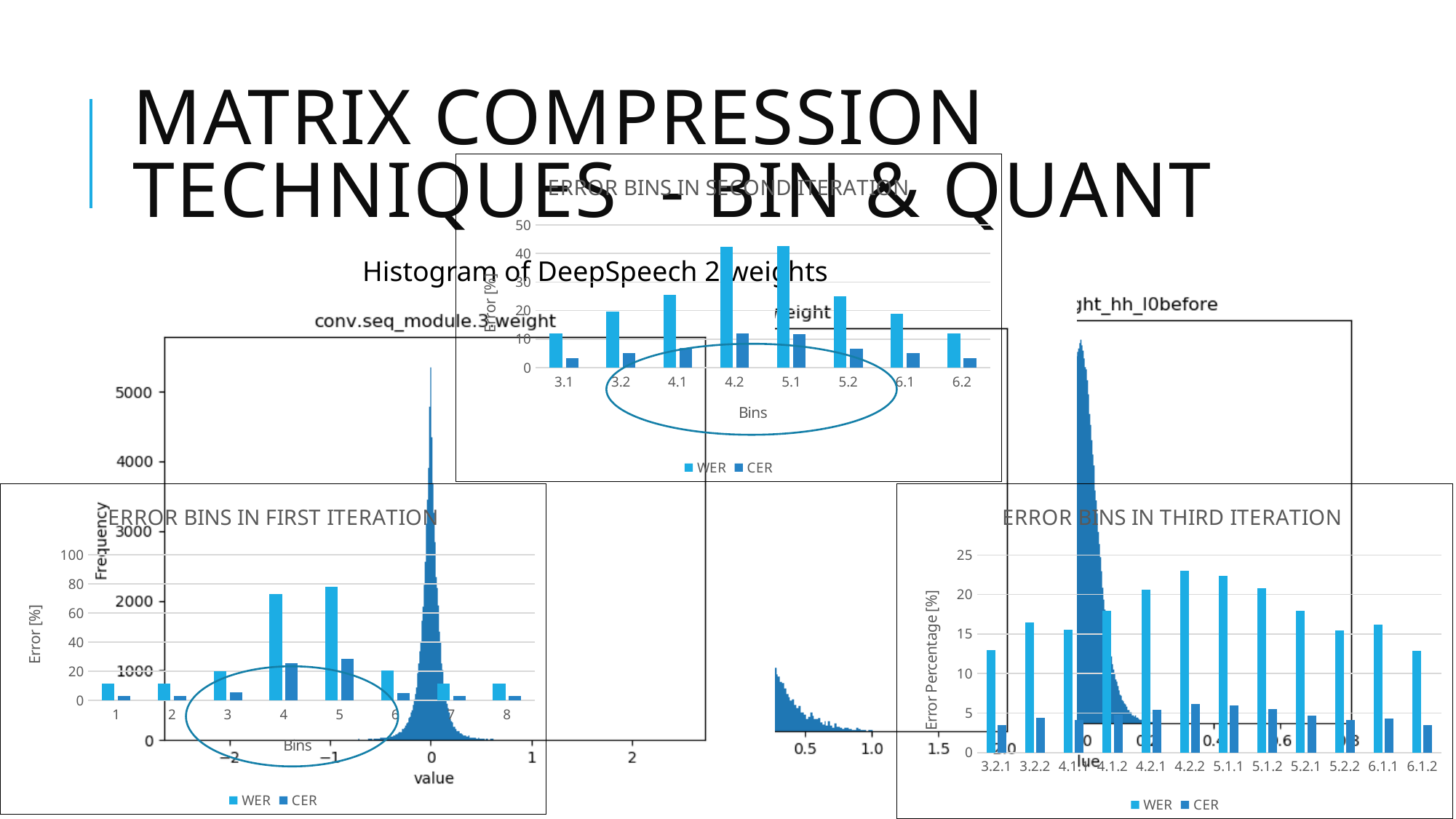
In "ERROR BINS IN SECOND ITERATION", how many bins are shown on the x axis? 8 In "ERROR BINS IN SECOND ITERATION", which bin has the lowest CER value, 3.1 or 4.2? 3.1 What kind of chart is "ERROR BINS IN FIRST ITERATION"? bar chart What is the y-axis label of "ERROR BINS IN THIRD ITERATION"? Error Percentage [%] In "ERROR BINS IN THIRD ITERATION", is the WER value for bin 3.2.1 greater or less than 15? less In "ERROR BINS IN FIRST ITERATION", is the CER value for bin 5 greater or less than 20? greater In "ERROR BINS IN THIRD ITERATION", how many bins are shown on the x axis? 12 In "ERROR BINS IN SECOND ITERATION", is the CER value for bin 3.1 greater or less than 10? less In "ERROR BINS IN FIRST ITERATION", which is larger, the WER value for bin 3 or the WER value for bin 4? bin 4 How many series does the legend of "ERROR BINS IN SECOND ITERATION" list? 2